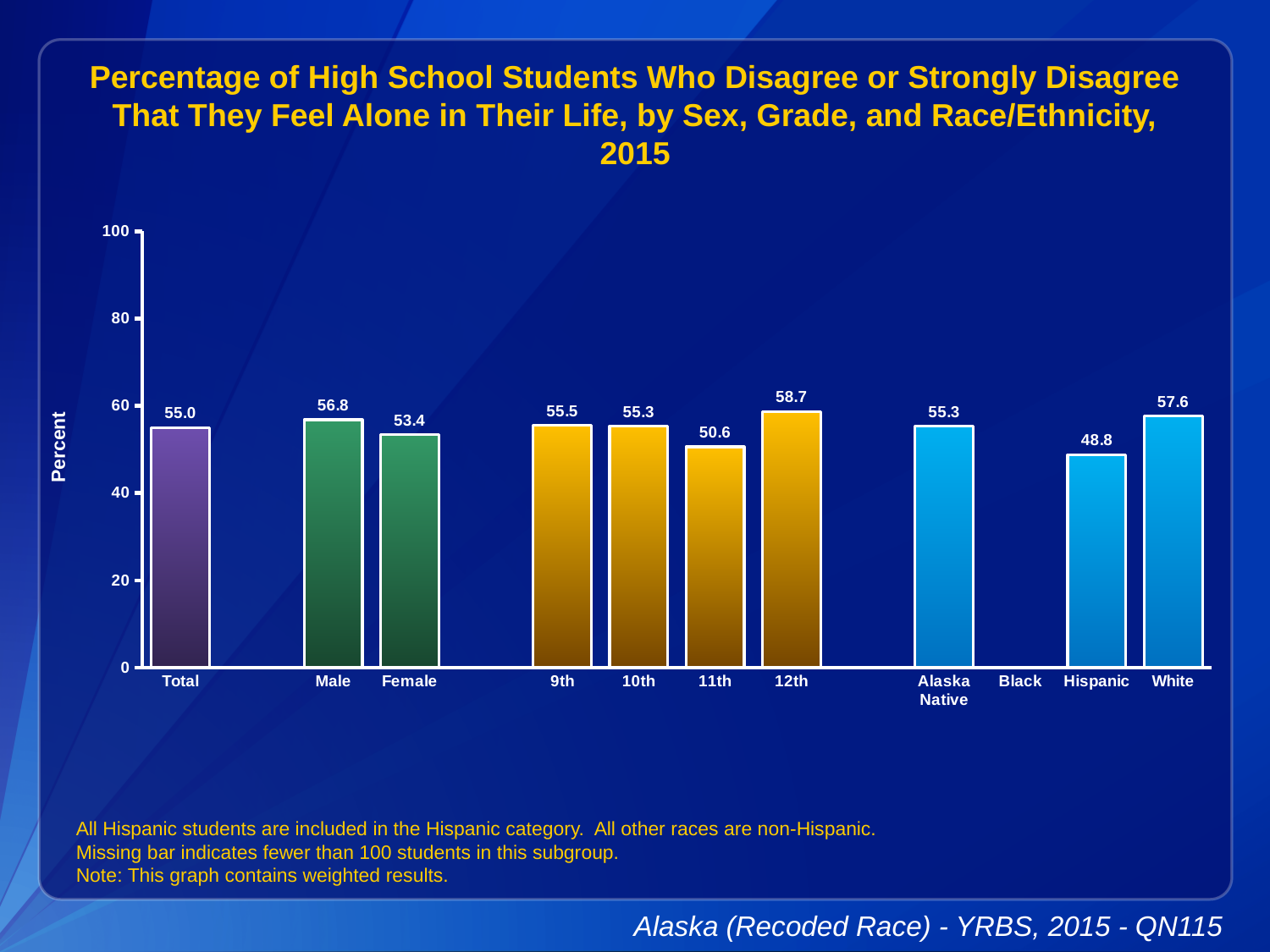
What is the value for Male? 56.8 How many categories are labeled on the x axis? 11 What is the value for 11th grade? 50.6 What is the difference between the Male and Female values? 3.4 Is the value for 12th grade greater or less than 40? greater Which category has the highest value? 12th What is the value for Total? 55.0 What kind of chart is shown? bar chart Which category with a bar has the lowest value? Hispanic Which category on the x axis has no bar? Black What is the value for Hispanic? 48.8 Which is larger, the value for White or the value for Alaska Native? White